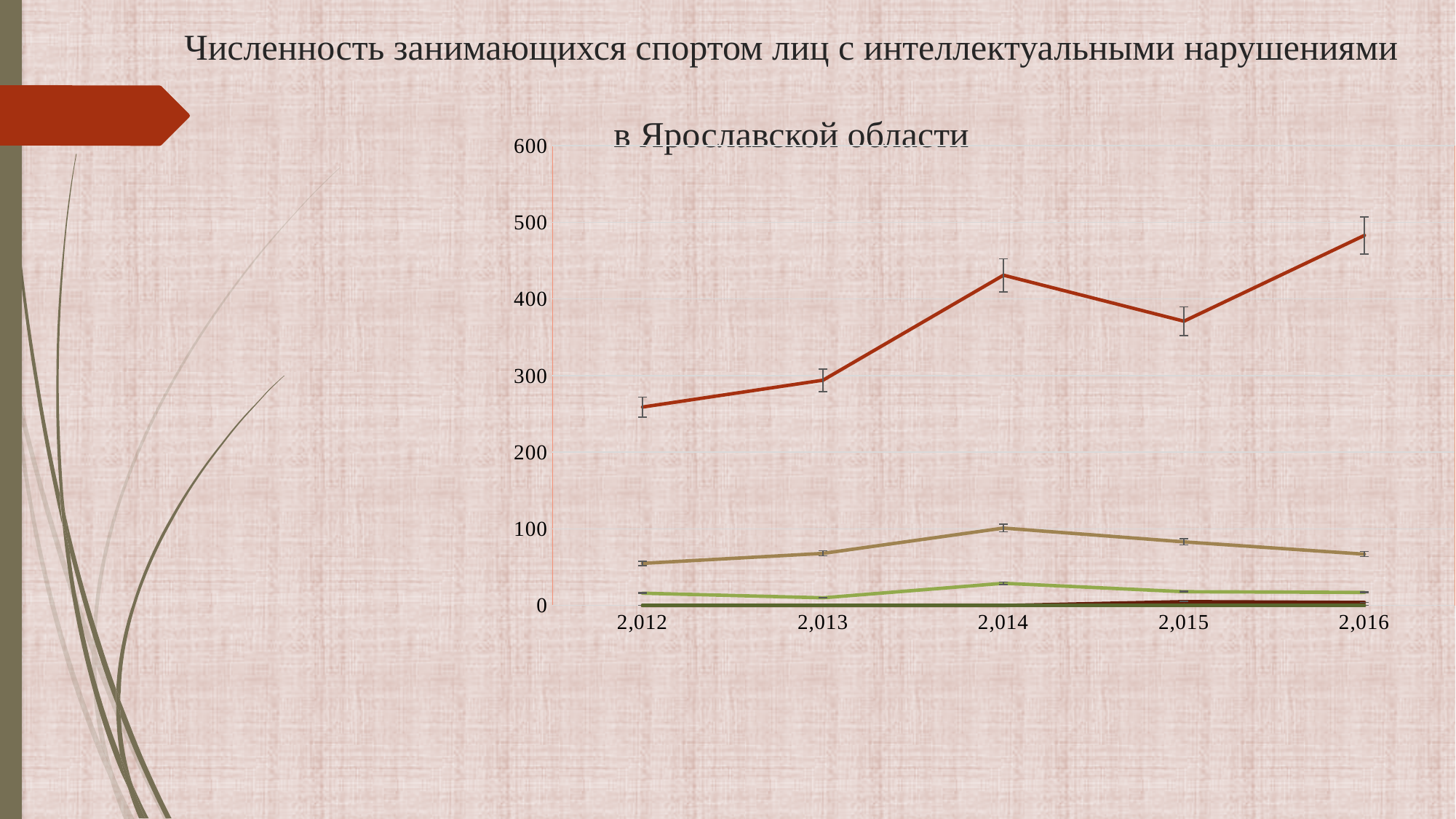
In which year does the red (top) line reach its highest value? 2,016 In which year does the red (top) line have its lowest value? 2,012 Does the red line rise or fall between 2,012 and 2,014? rise Is the value of the red line in 2,012 greater or less than 300? less For the red line, which year has the larger value: 2,014 or 2,015? 2,014 What is the title of the chart on the slide? Численность занимающихся спортом лиц с интеллектуальными нарушениями в Ярославской области Is the value of the red line in 2,016 greater or less than 400? greater Is the value of the red line in 2,014 greater or less than 400? greater What kind of chart is shown on the slide? line chart In which year does the tan (second from top) line reach its highest value? 2,014 How many years are shown on the x axis of the chart? 5